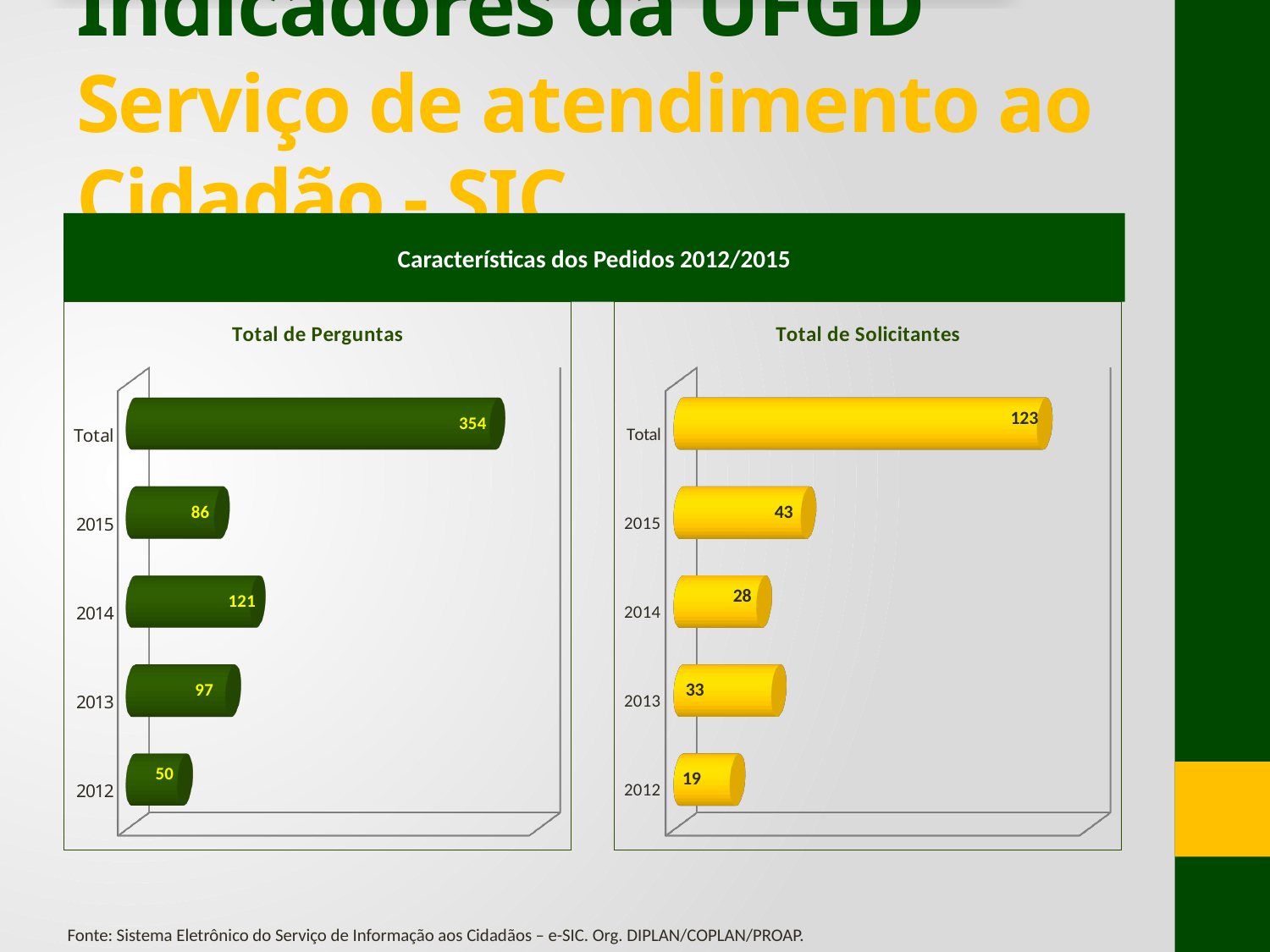
What kind of chart is the 'Total de Solicitantes' chart? Bar chart What is the title of the chart on the left? Total de Perguntas In the 'Total de Solicitantes' chart, what is the value for 2012? 19 In the 'Total de Solicitantes' chart, what is the difference between the values for 2015 and 2014? 15 What colour are the bars in the 'Total de Solicitantes' chart? Yellow In the 'Total de Solicitantes' chart, which year (excluding Total) has the highest value? 2015 In the 'Total de Perguntas' chart, what is the value for 2014? 121 How many bars are shown in the 'Total de Perguntas' chart? 5 In the 'Total de Solicitantes' chart, which is larger, the value for 2013 or the value for 2014? 2013 In the 'Total de Perguntas' chart, what is the value for Total? 354 In the 'Total de Perguntas' chart, what is the difference between the values for 2014 and 2013? 24 In the 'Total de Perguntas' chart, which year (excluding Total) has the lowest value? 2012